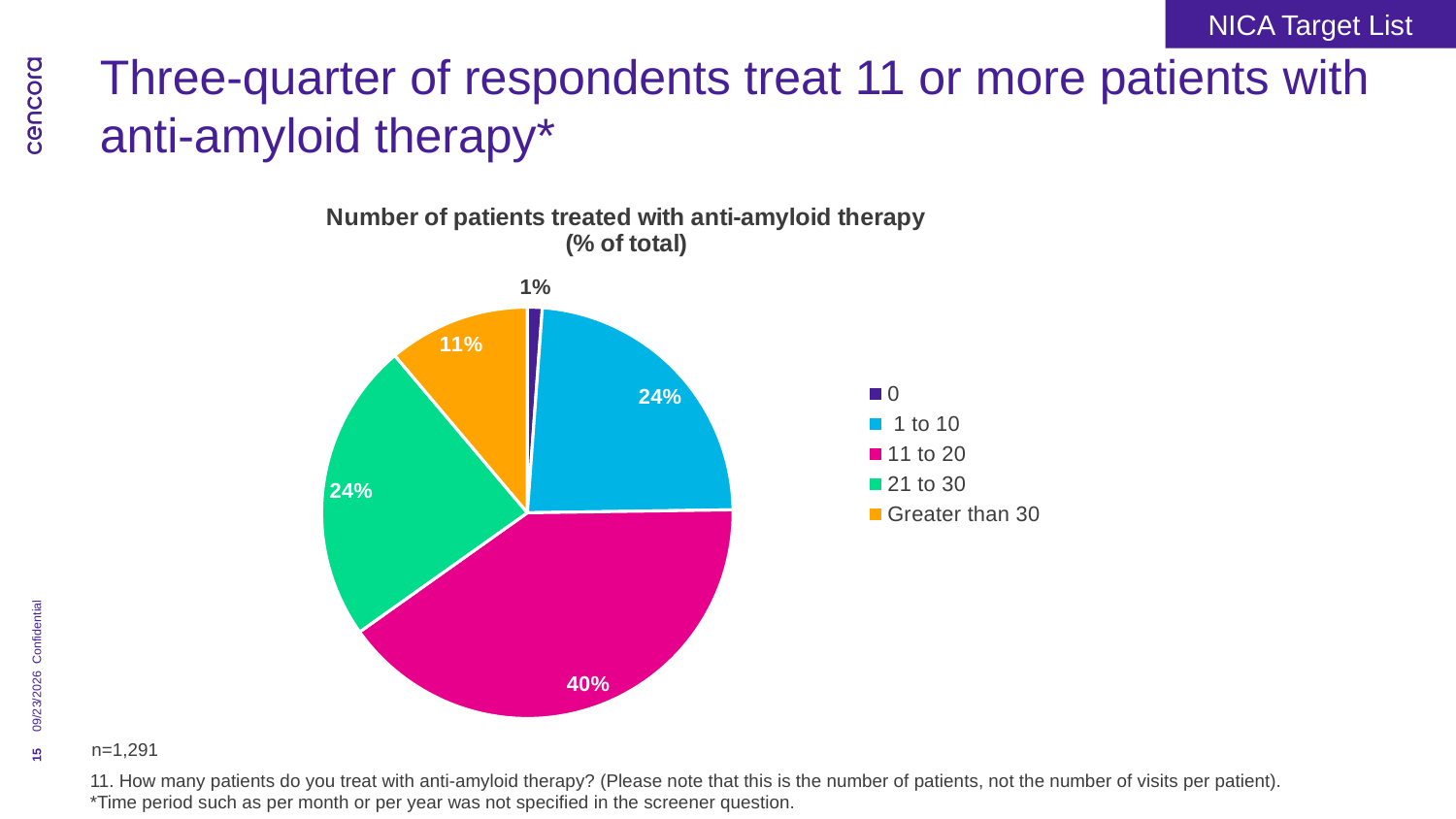
What is the title of the chart? Number of patients treated with anti-amyloid therapy (% of total) Which category has the largest share of the pie? 11 to 20 What kind of chart is shown on the slide? Pie chart What percentage of respondents treat greater than 30 patients with anti-amyloid therapy? 11% What percentage of respondents treat 1 to 10 patients with anti-amyloid therapy? 24% What is the combined share of respondents treating 21 to 30 and greater than 30 patients? 35% What is the difference in percentage points between the 11 to 20 category and the Greater than 30 category? 29 What percentage of respondents treat 11 to 20 patients with anti-amyloid therapy? 40% Which category has the smallest share of the pie? 0 Which is larger, the share for 11 to 20 or the share for 21 to 30? 11 to 20 How many categories does the legend list? 5 What percentage of respondents treat 0 patients with anti-amyloid therapy? 1%